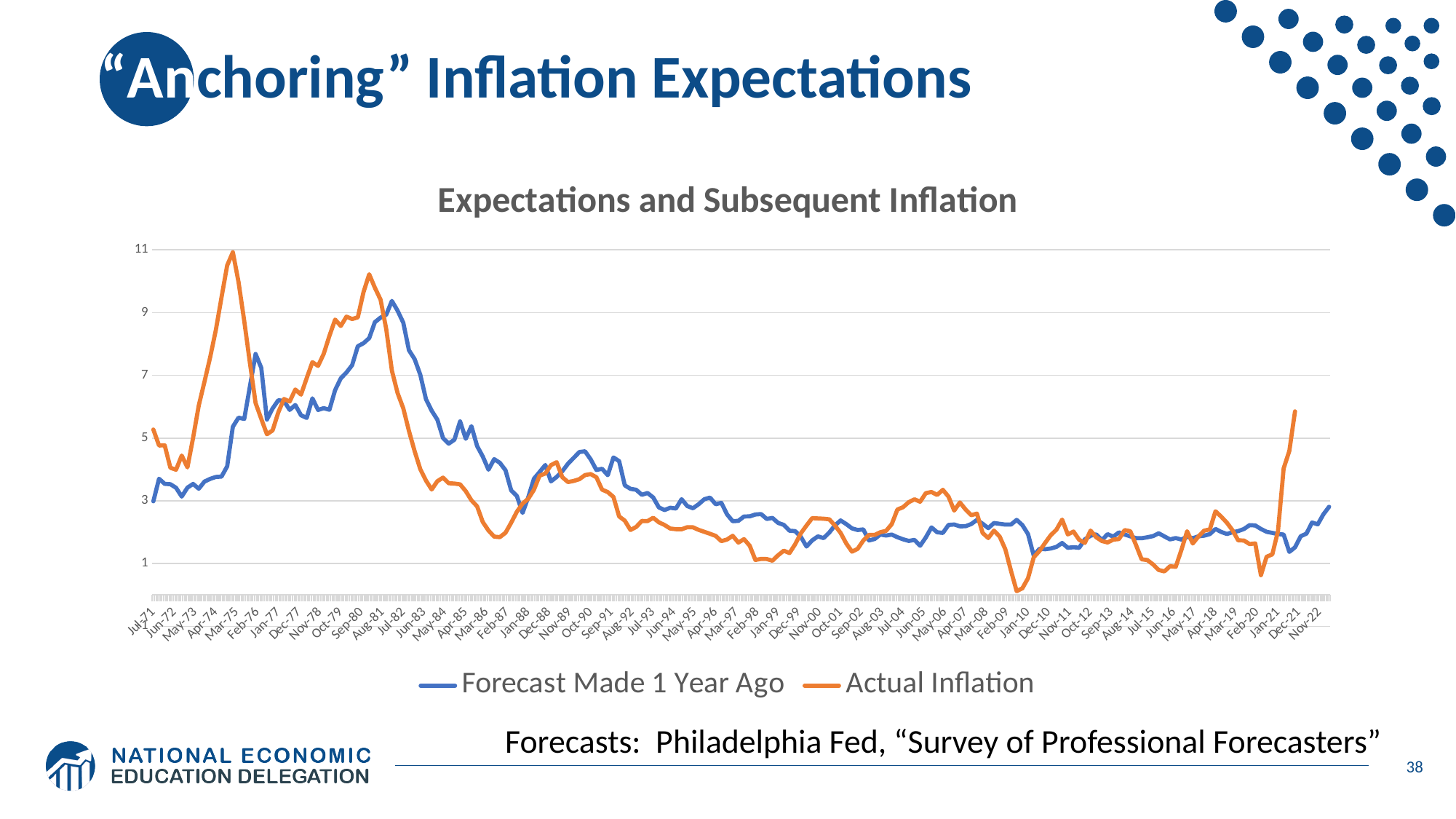
Is the value for Actual Inflation at Jan-10 greater or less than 1? less Which series reaches the highest value anywhere on the chart? Actual Inflation Is the value for Actual Inflation at Mar-75 greater or less than 9? greater What is the title of the chart? Expectations and Subsequent Inflation At Mar-75, which series has the higher value, Forecast Made 1 Year Ago or Actual Inflation? Actual Inflation Does Actual Inflation rise or fall between Jul-82 and Feb-87? Fall Which colour is used for the Actual Inflation line? Orange Which series reaches the lowest value anywhere on the chart? Actual Inflation How many series does the legend list? 2 Is the value for Forecast Made 1 Year Ago at Jul-82 greater or less than 7? greater What kind of chart is shown on the slide? Line chart